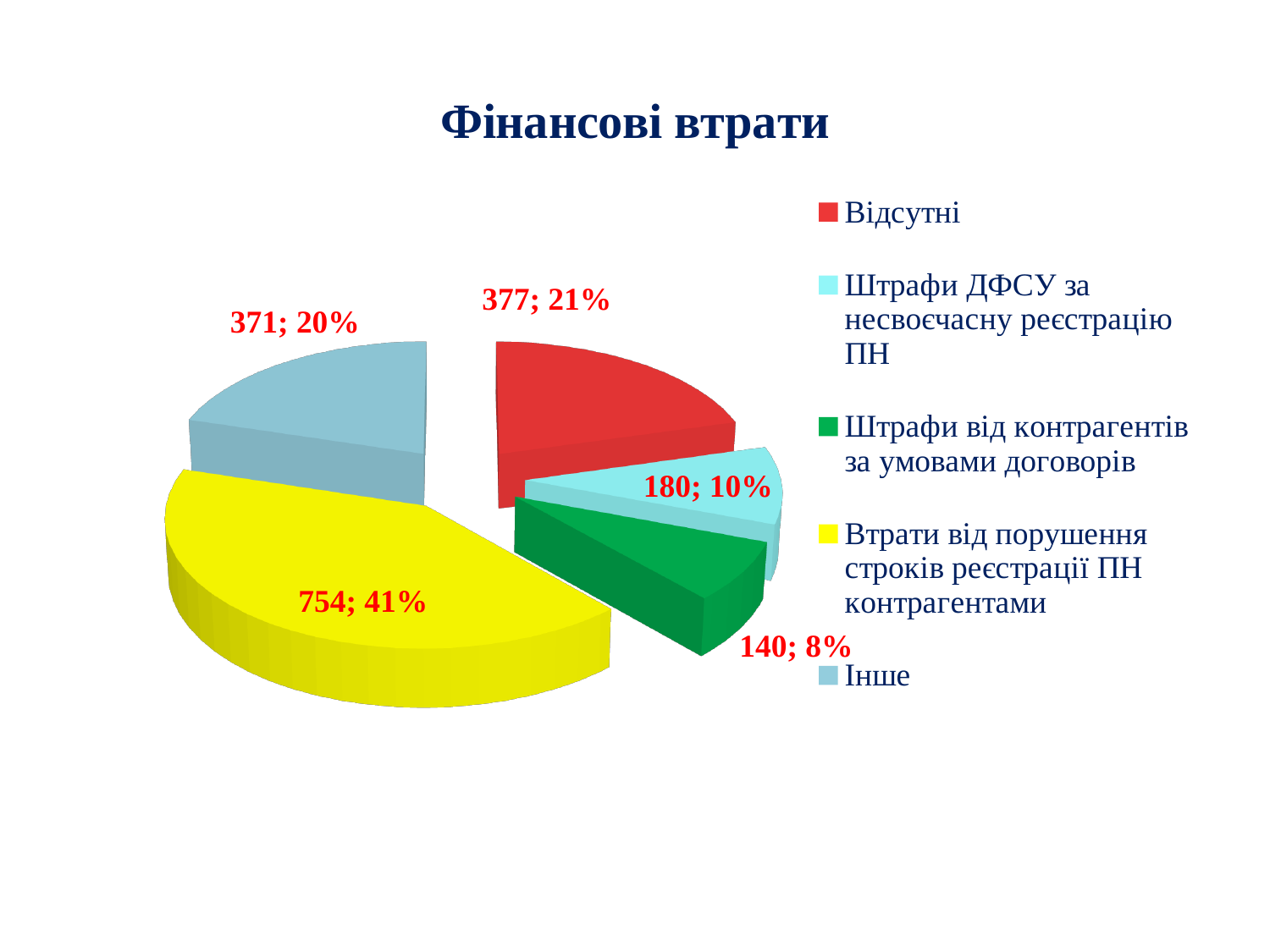
What colour is the slice for "Втрати від порушення строків реєстрації ПН контрагентами"? Yellow Which is larger: the value for "Інше" or the value for "Штрафи ДФСУ за несвоєчасну реєстрацію ПН"? Інше What value is shown for "Штрафи від контрагентів за умовами договорів"? 140 Which category has the smallest slice of the pie? Штрафи від контрагентів за умовами договорів What percentage share is shown for "Штрафи ДФСУ за несвоєчасну реєстрацію ПН"? 10% What percentage share is shown for the "Інше" slice? 20% What is the title of the chart? Фінансові втрати What is the difference between the values for "Відсутні" and "Інше"? 6 Which category has the largest slice of the pie? Втрати від порушення строків реєстрації ПН контрагентами What type of chart is shown on the slide? Pie chart What value is shown for the slice "Відсутні"? 377 How many slices does the pie chart have? 5